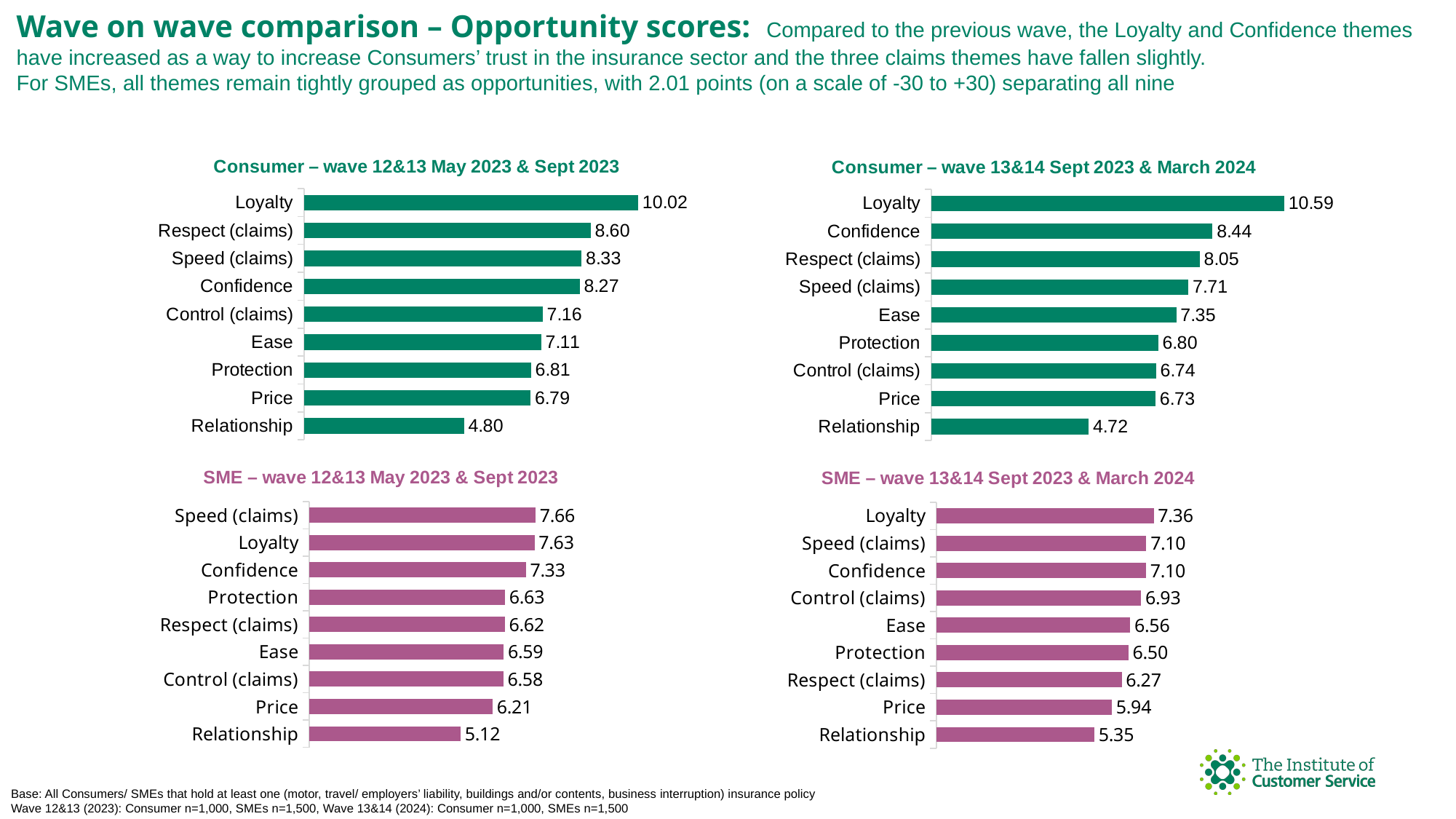
In the 'SME – wave 13&14 Sept 2023 & March 2024' chart, what is the difference between the Loyalty value and the Relationship value? 2.01 In the 'Consumer – wave 13&14 Sept 2023 & March 2024' chart, what is the value for Confidence? 8.44 In the 'Consumer – wave 13&14 Sept 2023 & March 2024' chart, which theme has the lowest value? Relationship How many themes are shown in the 'SME – wave 13&14 Sept 2023 & March 2024' chart? 9 What is the difference between the Loyalty value in the 'Consumer – wave 13&14 Sept 2023 & March 2024' chart and the Loyalty value in the 'Consumer – wave 12&13 May 2023 & Sept 2023' chart? 0.57 In the 'SME – wave 12&13 May 2023 & Sept 2023' chart, what is the value for Price? 6.21 In the 'Consumer – wave 12&13 May 2023 & Sept 2023' chart, what is the value for Loyalty? 10.02 In the 'Consumer – wave 13&14 Sept 2023 & March 2024' chart, which is larger, Confidence or Respect (claims)? Confidence What colour are the bars in the two SME charts? Pink/magenta In the 'SME – wave 13&14 Sept 2023 & March 2024' chart, what is the value for Control (claims)? 6.93 What type of chart is the 'Consumer – wave 12&13 May 2023 & Sept 2023' chart? Bar chart In the 'SME – wave 12&13 May 2023 & Sept 2023' chart, which theme has the highest value? Speed (claims)